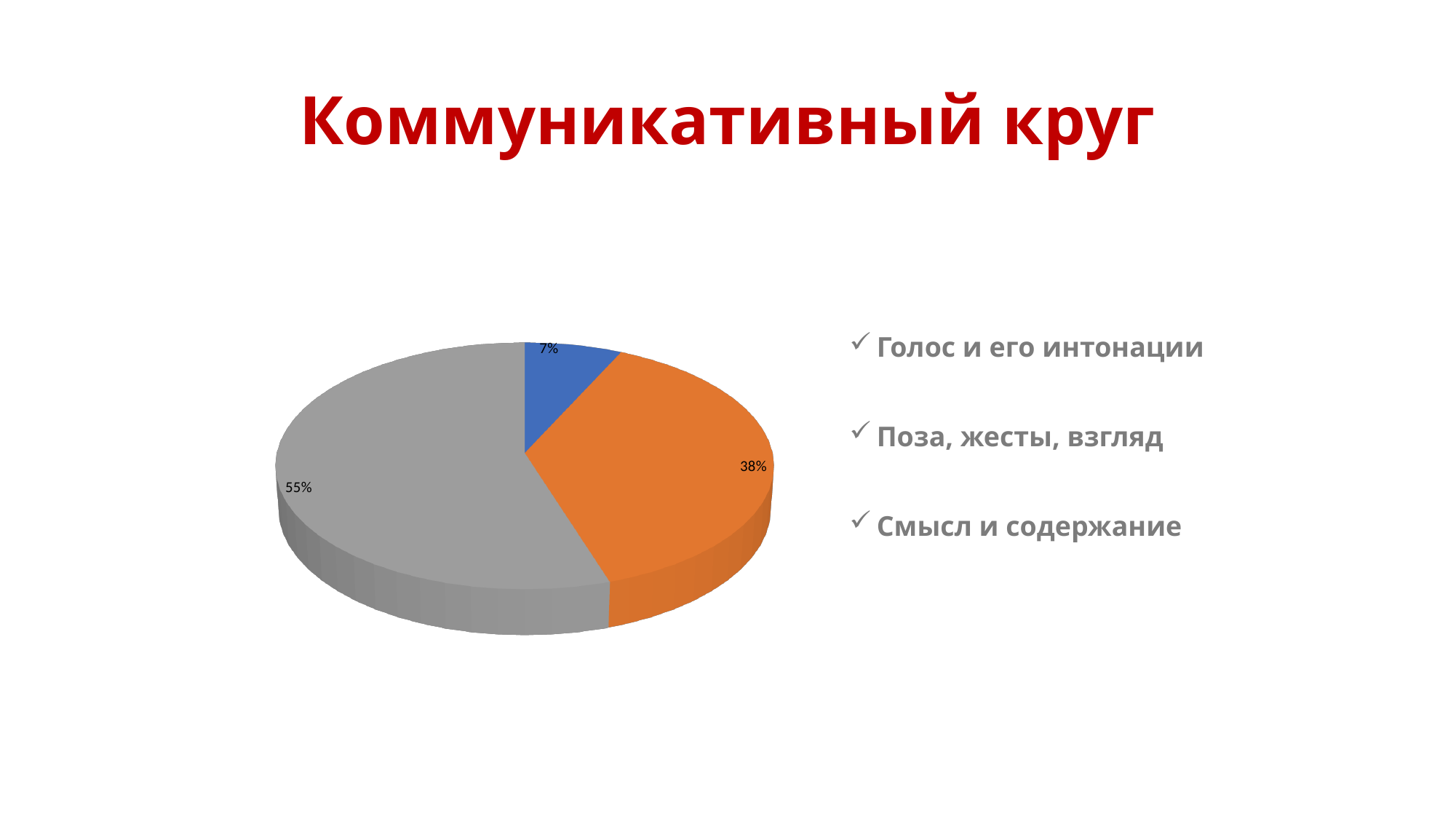
What is the value of the largest slice of the pie chart? 55% What is the value of the smallest slice of the pie chart? 7% What is the difference between the orange slice and the blue slice of the pie chart? 31% What colour is the largest slice of the pie chart? gray What percentage is shown on the orange slice of the pie chart? 38% What is the difference between the gray slice and the orange slice of the pie chart? 17% Which slice is larger in the pie chart, the orange one or the blue one? the orange one What percentage is shown on the gray slice of the pie chart? 55% How many slices does the pie chart have? 3 What kind of chart is shown on the slide? pie chart What percentage is shown on the blue slice of the pie chart? 7% What is the title of the slide containing the pie chart? Коммуникативный круг